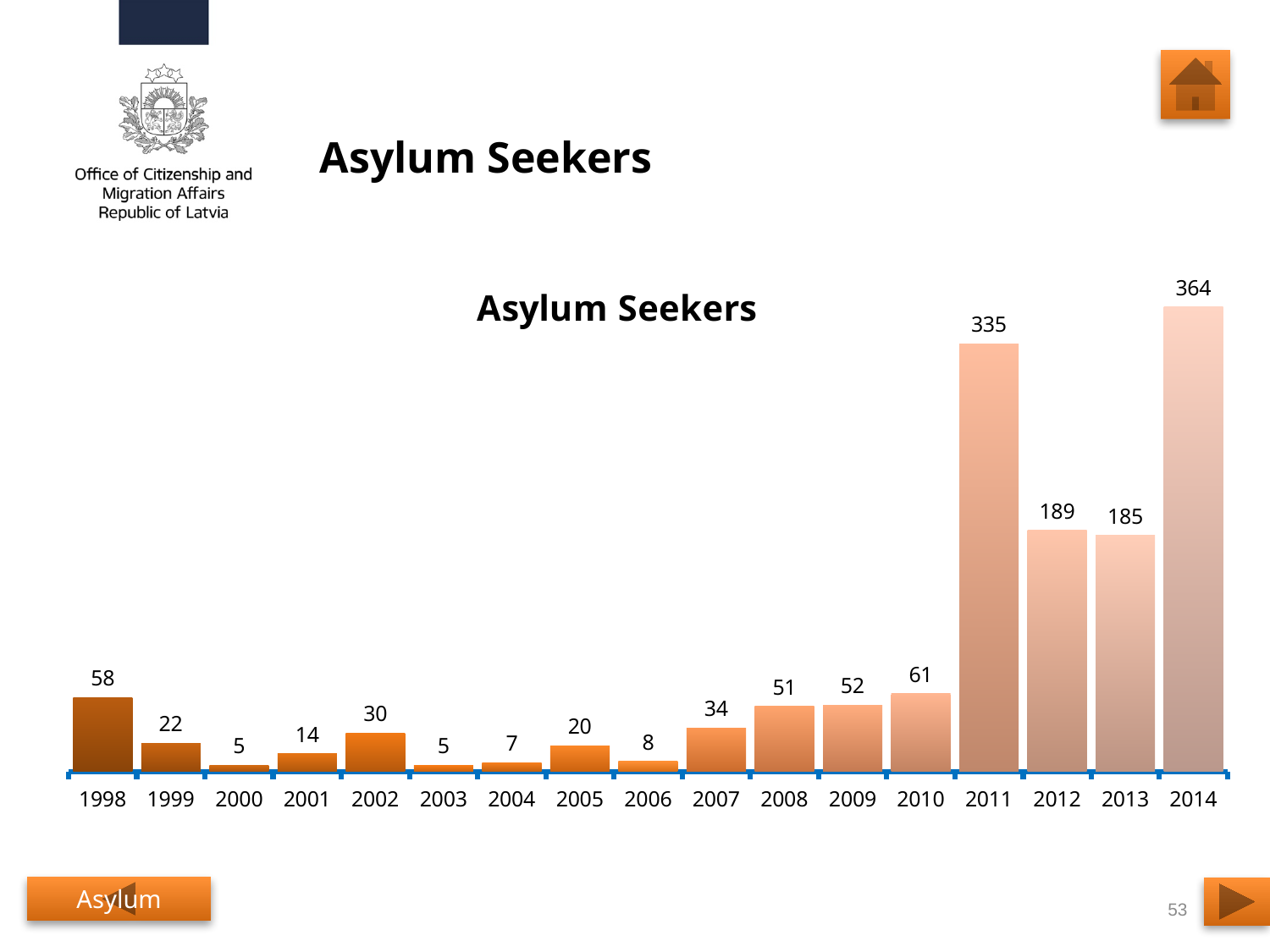
Which year has the highest value in the Asylum Seekers chart? 2014 What is the difference between the values for 2014 and 2013 in the Asylum Seekers chart? 179 Which years share the lowest value in the Asylum Seekers chart? 2000 and 2003 What is the title of the chart on the slide? Asylum Seekers What is the value for 2007 in the Asylum Seekers chart? 34 How many years are shown on the x axis of the Asylum Seekers chart? 17 Which is larger in the Asylum Seekers chart, the value for 1999 or the value for 2002? 2002 What is the value for 2011 in the Asylum Seekers chart? 335 Which is larger in the Asylum Seekers chart, the value for 2012 or the value for 2013? 2012 What kind of chart is the Asylum Seekers chart? bar chart What is the value for 1998 in the Asylum Seekers chart? 58 What is the difference between the values for 2011 and 2010 in the Asylum Seekers chart? 274